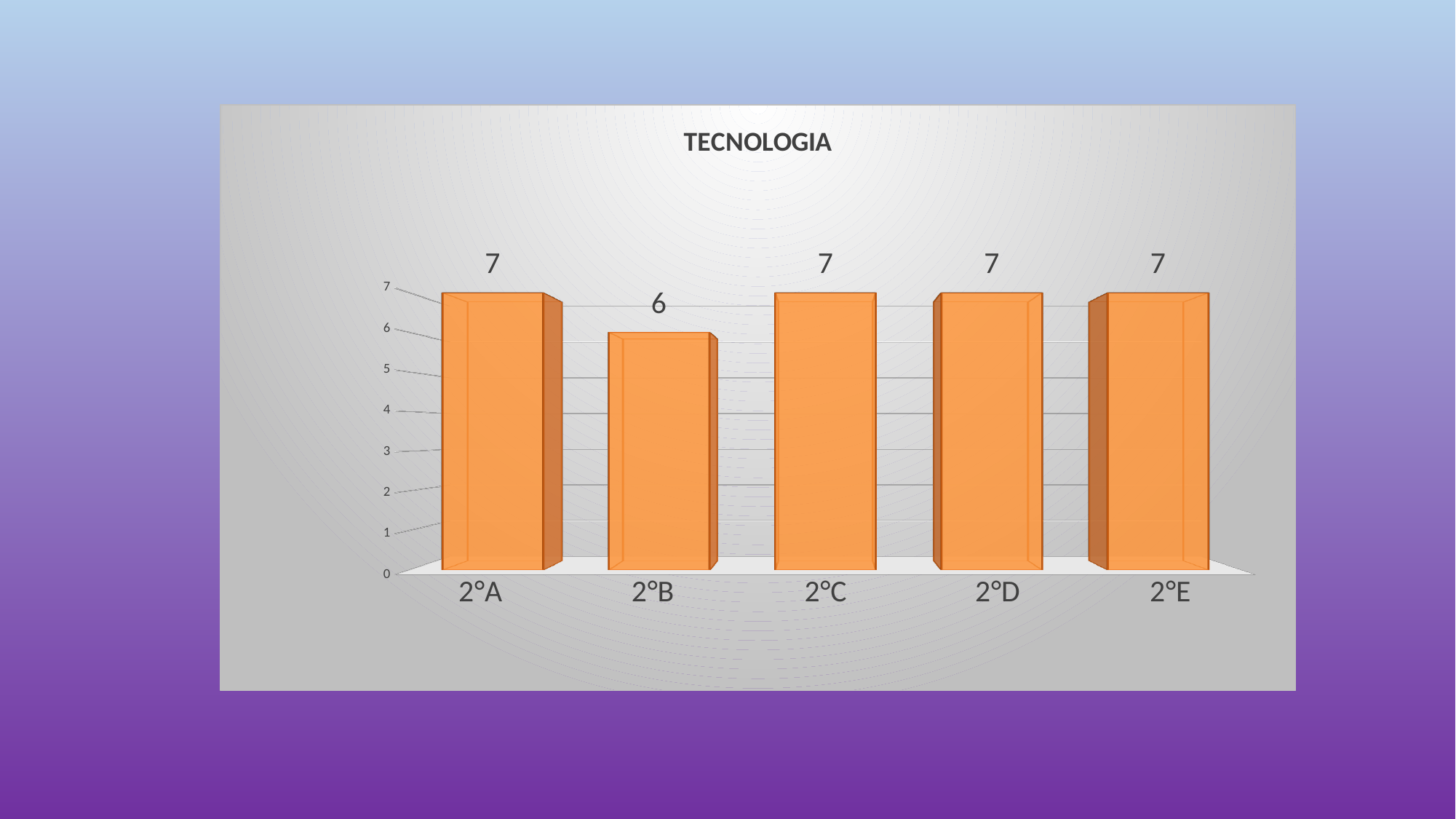
What kind of chart is shown? bar chart What is the difference between the values for 2°A and 2°B? 1 What is the value for 2°A? 7 Which is larger, the value for 2°C or the value for 2°B? 2°C How many categories are shown on the x axis? 5 What is the value for 2°E? 7 Is the value for 2°B greater or less than 5? greater How many categories have a value of 7? 4 Which category has the lowest value? 2°B What is the value for 2°B? 6 What colour are the bars? orange What is the title of the chart? TECNOLOGIA